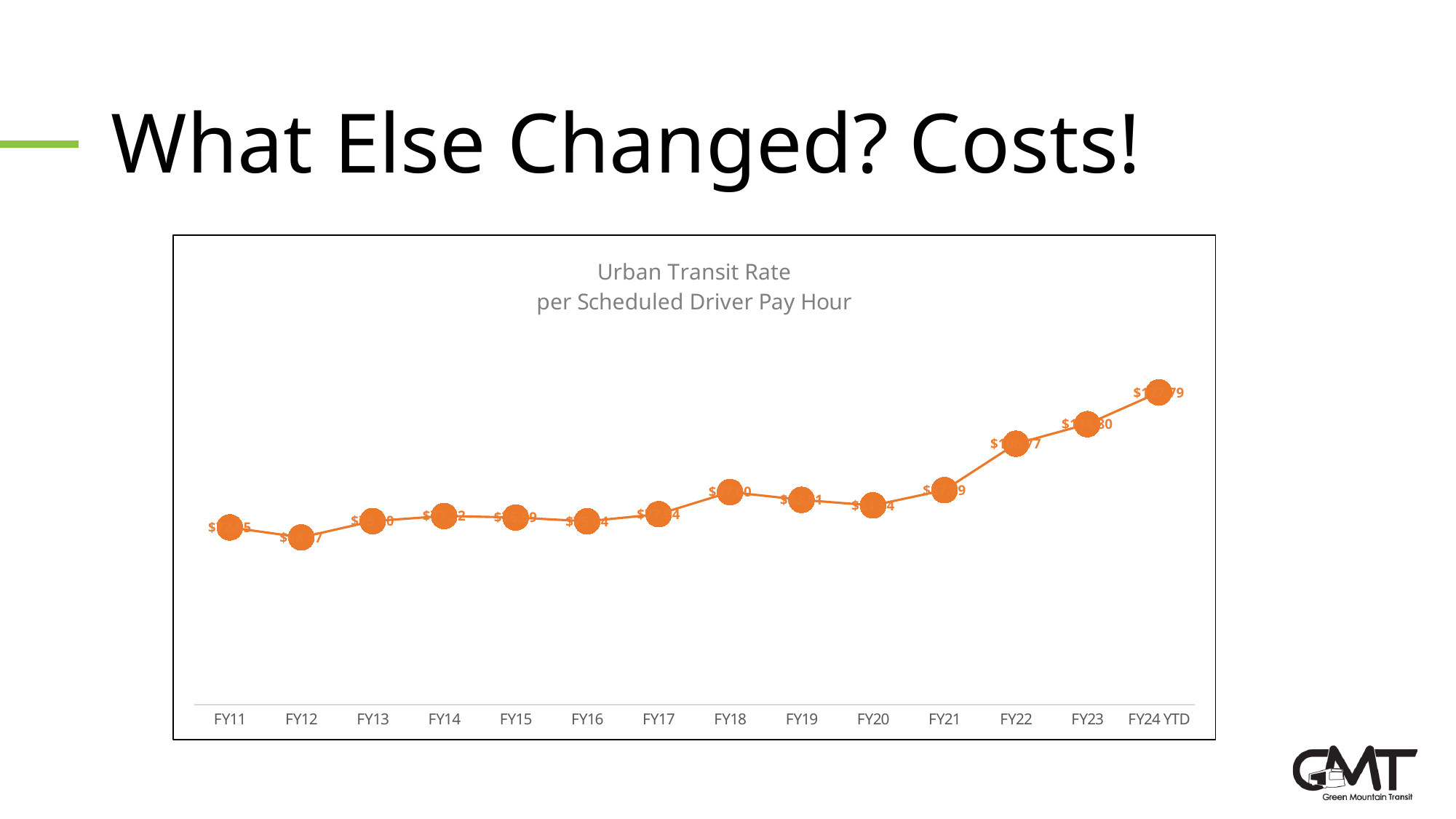
Which fiscal year has the highest urban transit rate per scheduled driver pay hour? FY24 YTD Which is higher, the rate for FY23 or the rate for FY20? FY23 Overall, does the urban transit rate per scheduled driver pay hour rise or fall from FY11 to FY24 YTD? rise What kind of chart is shown on the slide? line chart Which is higher, the rate for FY18 or the rate for FY17? FY18 What is the first fiscal year shown on the x axis? FY11 Which is higher, the rate for FY11 or the rate for FY12? FY11 How many fiscal years are plotted on the x axis? 14 What is the title of the chart? Urban Transit Rate per Scheduled Driver Pay Hour Which fiscal year has the lowest urban transit rate per scheduled driver pay hour? FY12 Between FY21 and FY24 YTD, does the rate rise or fall? rise